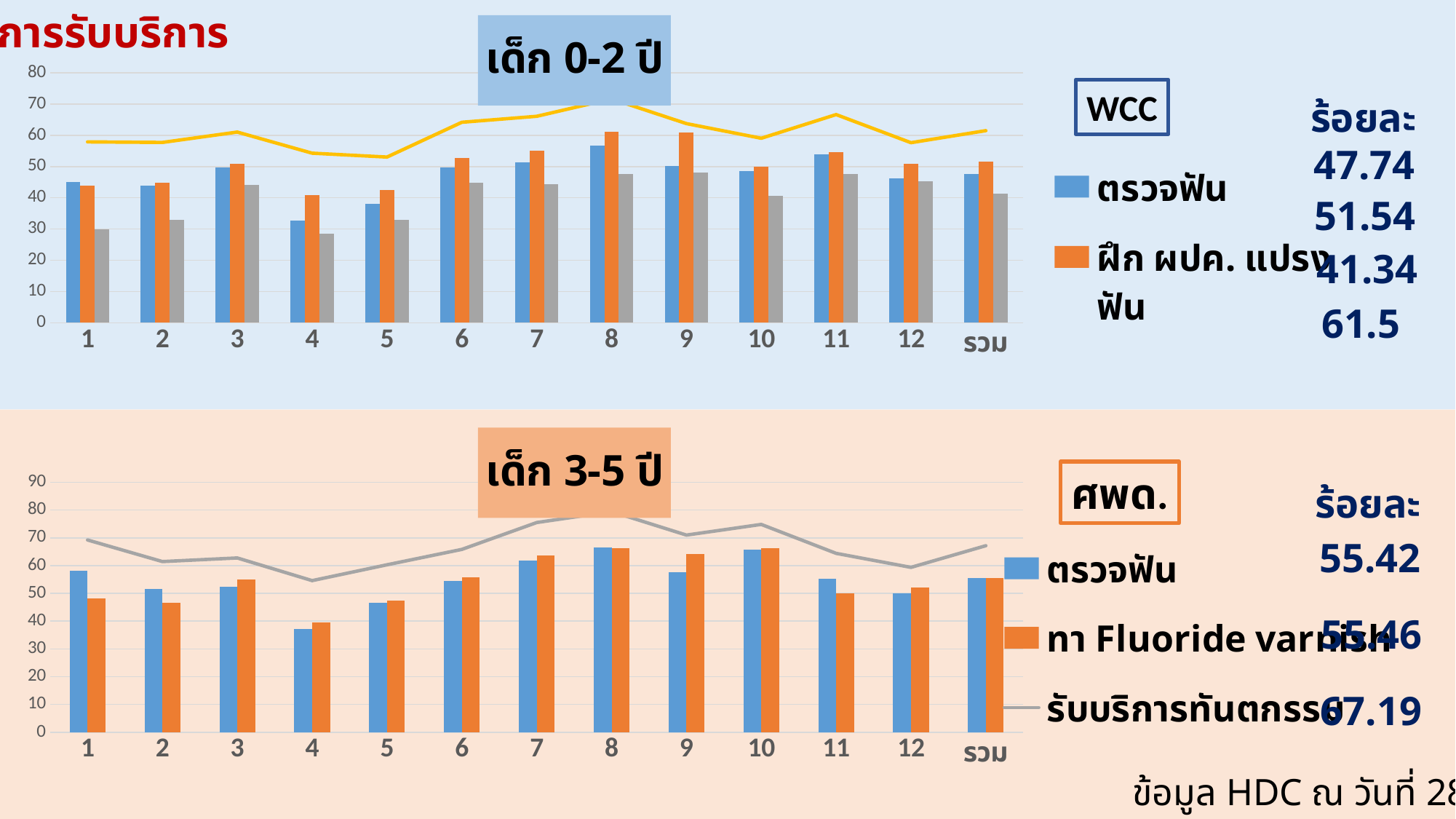
In the top chart (เด็ก 0-2 ปี), is the ตรวจฟัน value for month 8 greater or less than 50? greater In the top chart (เด็ก 0-2 ปี), for month 4, which is larger: ตรวจฟัน or ฝึก ผปค. แปรงฟัน? ฝึก ผปค. แปรงฟัน In the top chart (เด็ก 0-2 ปี), how many categories are shown on the x axis? 13 In the bottom chart (เด็ก 3-5 ปี), for month 1, which is larger: ตรวจฟัน or ทา Fluoride varnish? ตรวจฟัน In the top chart (เด็ก 0-2 ปี), which month has the lowest ตรวจฟัน bar? 4 How many series does the legend of the bottom chart (เด็ก 3-5 ปี) list? 3 In the top chart (เด็ก 0-2 ปี), is the ตรวจฟัน value for month 4 greater or less than 40? less In the bottom chart (เด็ก 3-5 ปี), is the ตรวจฟัน value for month 1 greater or less than 50? greater What kind of chart is the top chart titled เด็ก 0-2 ปี? bar chart (with a line) In the bottom chart (เด็ก 3-5 ปี), which series is drawn as a line rather than bars? รับบริการทันตกรรม In the bottom chart (เด็ก 3-5 ปี), which month has the lowest ตรวจฟัน bar? 4 In the bottom chart (เด็ก 3-5 ปี), do the ตรวจฟัน bars rise or fall from month 4 to month 8? rise